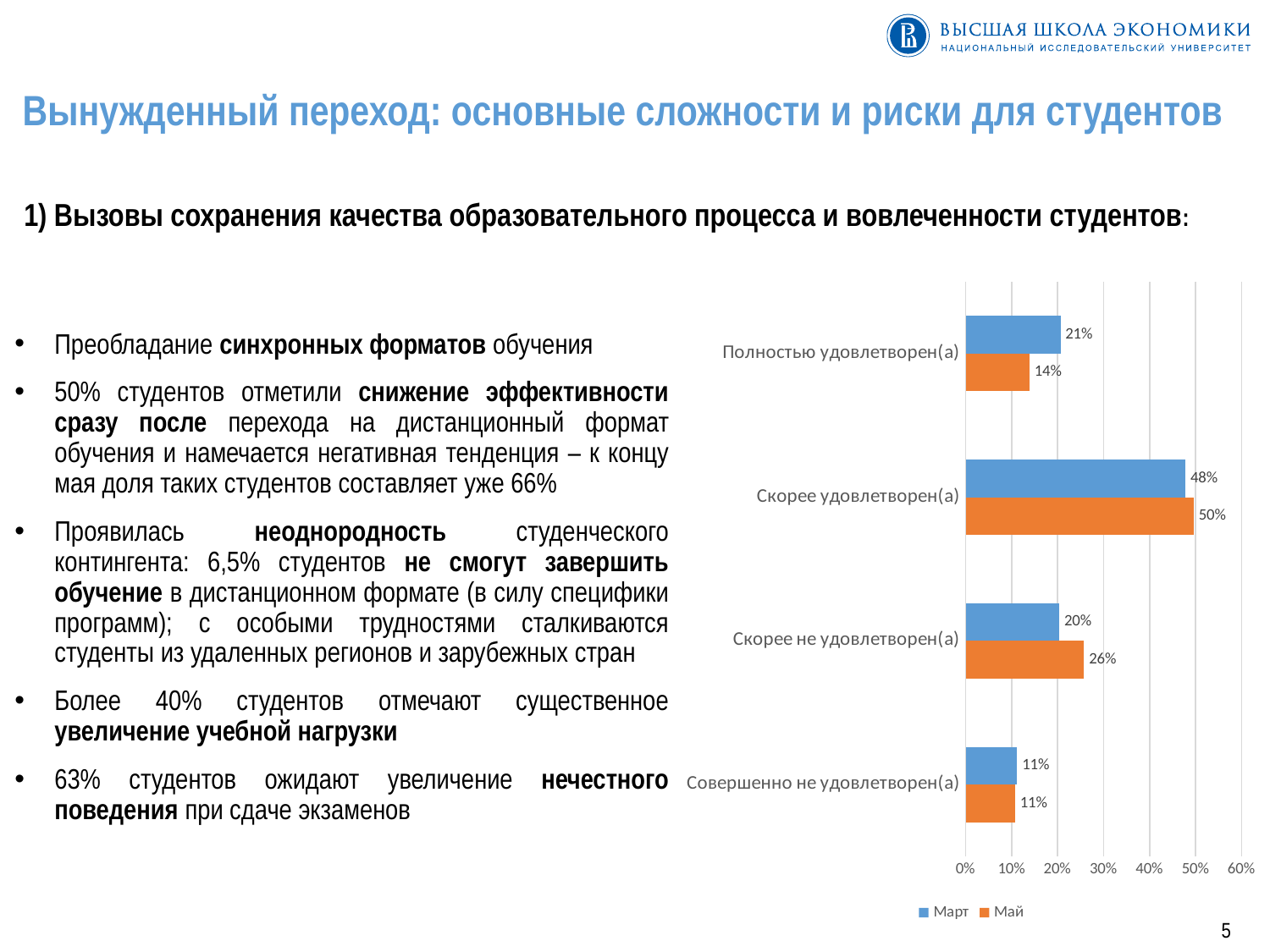
What is the value for "Май" in the "Скорее не удовлетворен(а)" category? 26% What is the value for "Март" in the "Полностью удовлетворен(а)" category? 21% Which category has the lowest value for the "Май" series? Совершенно не удовлетворен(а) What is the difference between the "Март" and "Май" values for "Полностью удовлетворен(а)"? 7% For "Скорее не удовлетворен(а)", which series has the larger value, "Март" or "Май"? Май How many categories are shown on the chart? 4 Which category has the highest value for the "Март" series? Скорее удовлетворен(а) Is the "Май" value for "Скорее удовлетворен(а)" greater or less than 40%? greater What type of chart is shown on the slide? bar chart How many series does the chart legend list? 2 What are the two series names listed in the chart legend? Март and Май What is the value for "Май" in the "Скорее удовлетворен(а)" category? 50%